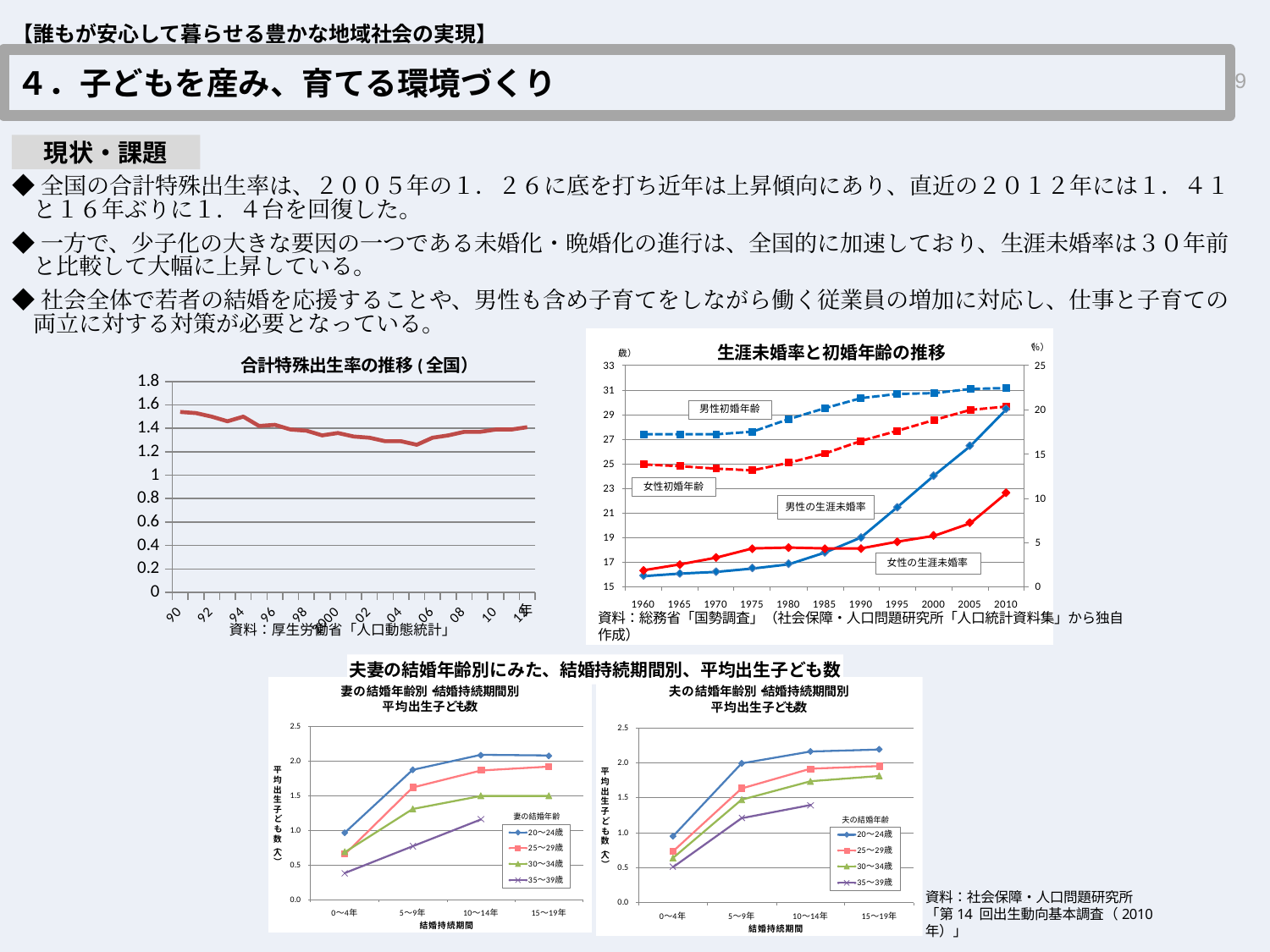
In the 合計特殊出生率の推移(全国) chart, does the value rise or fall from '90 to '05? fall In the 生涯未婚率と初婚年齢の推移 chart, does 男性の生涯未婚率 rise or fall from 1985 to 2010? rise In the 生涯未婚率と初婚年齢の推移 chart, how many years are shown on the x axis? 11 In the 生涯未婚率と初婚年齢の推移 chart, is the 男性の生涯未婚率 value for 2010 greater or less than 15%? greater In the 合計特殊出生率の推移(全国) chart, is the value for '05 greater or less than 1.4? less In the 妻の結婚年齢別・結婚持続期間別 平均出生子ども数 chart, how many series does the legend list? 4 In the 生涯未婚率と初婚年齢の推移 chart, which is higher in 2010, 男性の生涯未婚率 or 女性の生涯未婚率? 男性の生涯未婚率 What kind of chart is the 合計特殊出生率の推移(全国) chart? line chart In the 生涯未婚率と初婚年齢の推移 chart, how many series are plotted? 4 In the 生涯未婚率と初婚年齢の推移 chart, is the 女性の生涯未婚率 value for 2010 greater or less than 15%? less